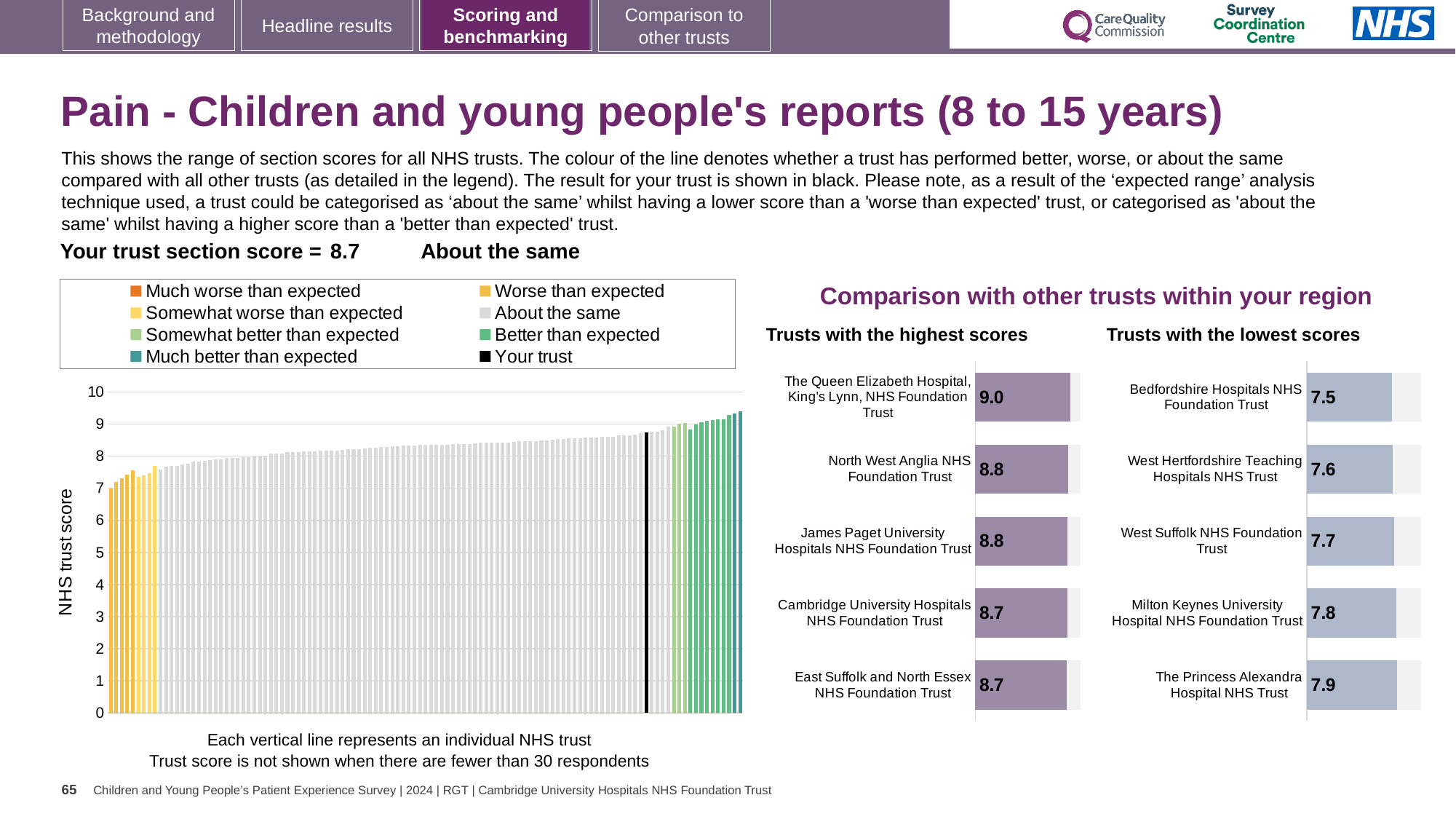
In the 'Trusts with the lowest scores' chart, what is the score for West Suffolk NHS Foundation Trust? 7.7 In the 'Trusts with the lowest scores' chart, what is the difference between the scores for The Princess Alexandra Hospital NHS Trust and Bedfordshire Hospitals NHS Foundation Trust? 0.4 In the 'Trusts with the lowest scores' chart, which trust has the lowest score? Bedfordshire Hospitals NHS Foundation Trust What kind of chart is the large chart on the left showing NHS trust scores? bar chart In the 'Trusts with the highest scores' chart, what is the difference between the score for The Queen Elizabeth Hospital, King's Lynn and the score for North West Anglia NHS Foundation Trust? 0.2 In the 'Trusts with the highest scores' chart, which trust has the lowest score shown? Cambridge University Hospitals NHS Foundation Trust and East Suffolk and North Essex NHS Foundation Trust (both 8.7) In the large chart on the left, is the value for the black 'Your trust' bar greater or less than 8? greater Which is larger: the score for Milton Keynes University Hospital NHS Foundation Trust in the 'lowest scores' chart or the score for Cambridge University Hospitals NHS Foundation Trust in the 'highest scores' chart? Cambridge University Hospitals NHS Foundation Trust (8.7) How many trusts are listed in the 'Trusts with the highest scores' chart? 5 In the 'Trusts with the lowest scores' chart, which trust has the highest score? The Princess Alexandra Hospital NHS Trust In the 'Trusts with the highest scores' chart, what is the score for The Queen Elizabeth Hospital, King's Lynn, NHS Foundation Trust? 9.0 In the large chart on the left, do the trust scores rise or fall from left to right? rise